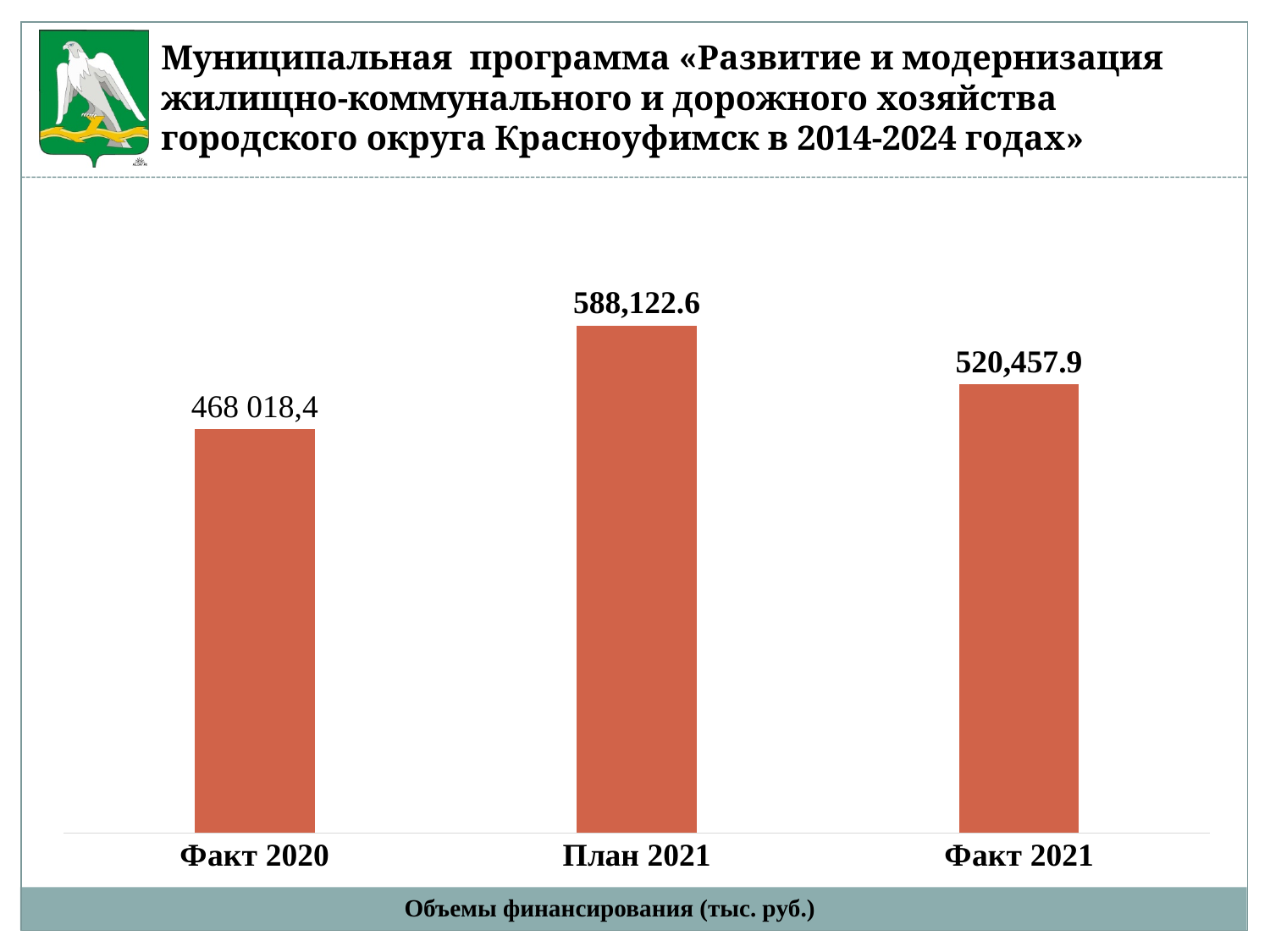
What is the value shown for План 2021? 588,122.6 What is the value shown for Факт 2020? 468 018,4 What is the difference between the values for План 2021 and Факт 2021? 67,664.7 What kind of chart is shown on the slide? Bar chart What is the value shown for Факт 2021? 520,457.9 What is the difference between the values for Факт 2021 and Факт 2020? 52,439.5 Which is larger, the value for Факт 2021 or the value for Факт 2020? Факт 2021 Which category has the lowest value? Факт 2020 What unit of measurement is given in the caption below the chart? тыс. руб. How many bars are shown in the chart? 3 Which category has the highest value? План 2021 Does the value rise or fall from План 2021 to Факт 2021? Fall